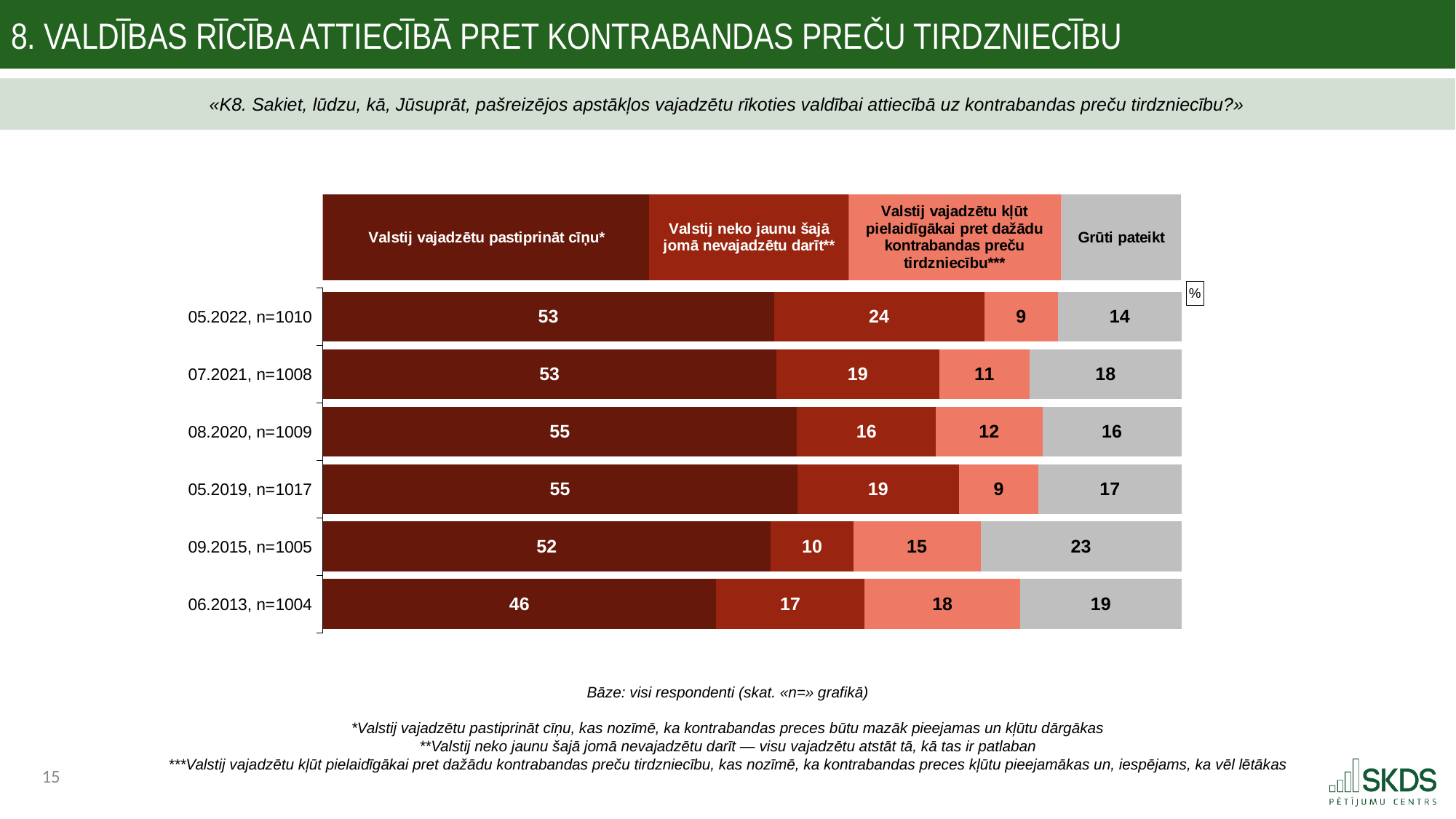
What is the value for "Valstij neko jaunu šajā jomā nevajadzētu darīt**" in 06.2013, n=1004? 17 In which survey wave is the value for "Valstij neko jaunu šajā jomā nevajadzētu darīt**" the highest? 05.2022, n=1010 What is the value for "Valstij vajadzētu kļūt pielaidīgākai pret dažādu kontrabandas preču tirdzniecību***" in 08.2020, n=1009? 12 Which is larger: the "Valstij vajadzētu kļūt pielaidīgākai pret dažādu kontrabandas preču tirdzniecību***" value in 06.2013, n=1004 or in 05.2019, n=1017? 06.2013, n=1004 How many survey waves (bars) are shown in the chart? 6 How many series does the chart legend list? 4 What is the value for "Valstij vajadzētu pastiprināt cīņu*" in 05.2022, n=1010? 53 What is the total of the stacked bar for 07.2021, n=1008? 101 What kind of chart is shown on the slide? Stacked bar chart What is the difference between the "Grūti pateikt" values for 09.2015, n=1005 and 05.2022, n=1010? 9 What is the value for "Grūti pateikt" in 09.2015, n=1005? 23 In which survey wave is the value for "Valstij vajadzētu pastiprināt cīņu*" the lowest? 06.2013, n=1004